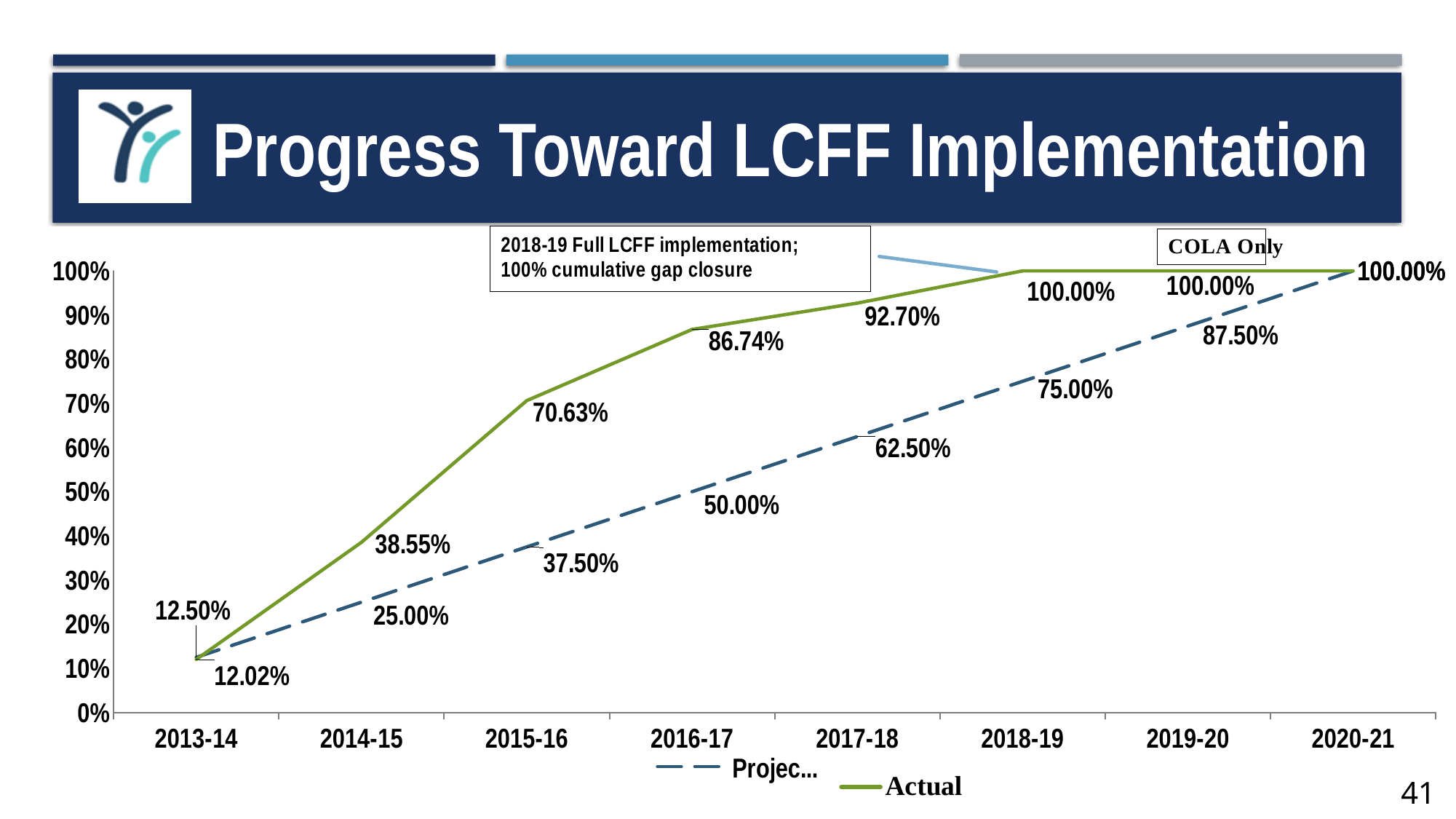
What is the value of the dashed (Projec...) series for 2019-20? 87.50% What is the value of the dashed (Projec...) series for 2016-17? 50.00% Which is larger in 2014-15, the Actual value or the dashed (Projec...) value? Actual What type of chart is shown on the slide? line chart What is the Actual value for 2015-16? 70.63% What is the Actual value for 2017-18? 92.70% Does the Actual series rise or fall from 2013-14 to 2018-19? rise How many years are shown on the x axis? 8 How many series does the legend list? 2 What is the title of the chart? Progress Toward LCFF Implementation What is the difference between the Actual value and the dashed (Projec...) value in 2015-16? 33.13% In which year is the Actual value lowest? 2013-14